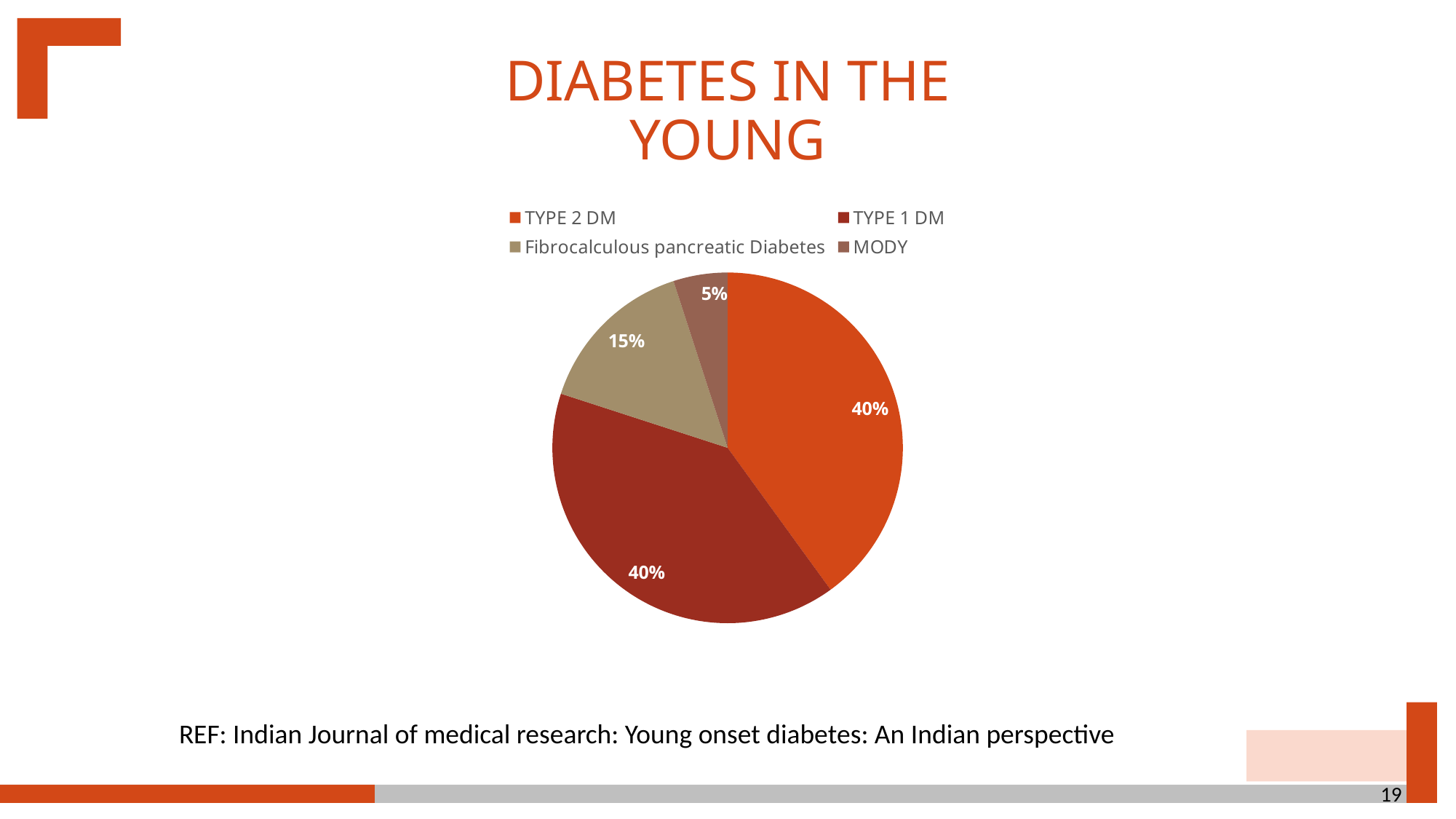
How many entries does the legend list? 4 How many slices does the pie chart have? 4 What share of the pie does TYPE 2 DM represent? 40% Which is larger, the share for Fibrocalculous pancreatic Diabetes or the share for MODY? Fibrocalculous pancreatic Diabetes What is the title of the slide containing the pie chart? DIABETES IN THE YOUNG What is the difference between the share for Fibrocalculous pancreatic Diabetes and the share for MODY? 10% What kind of chart is shown on the slide? pie chart Which category has the smallest slice of the pie? MODY What share of the pie does MODY represent? 5% What is the difference between the share for TYPE 2 DM and the share for Fibrocalculous pancreatic Diabetes? 25% What share of the pie does Fibrocalculous pancreatic Diabetes represent? 15% What share of the pie does TYPE 1 DM represent? 40%